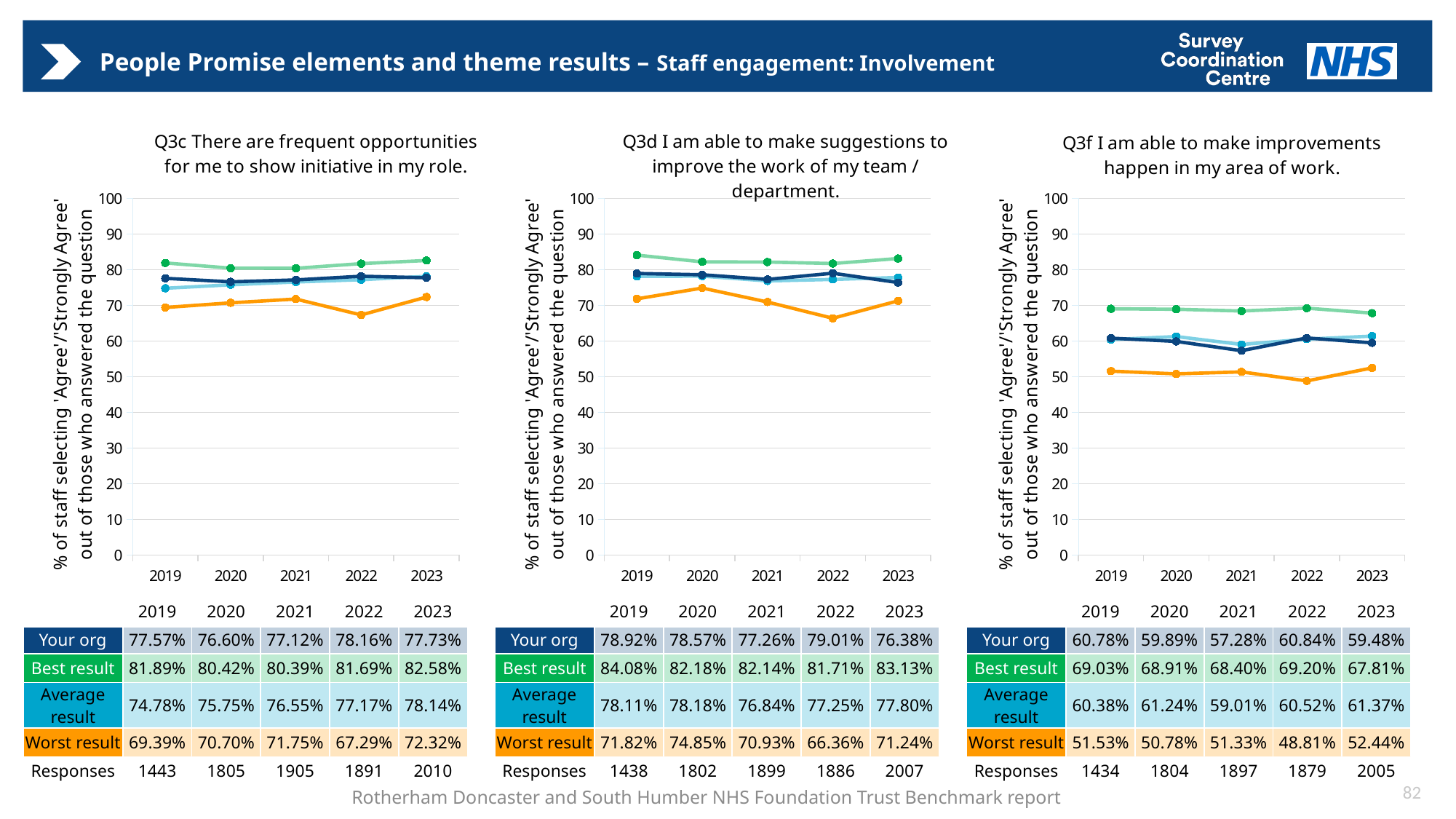
In the Q3f chart, in which year is the Worst result value lowest? 2022 In the Q3c chart, does the Average result line rise or fall from 2019 to 2023? rises In the Q3f chart, is the Worst result value for 2022 greater or less than 50? less In the Q3f chart, how many series (lines) are plotted? 4 In the Q3f chart, which is larger in 2021: the Your org value or the Average result value? Average result What kind of chart is the Q3d chart? line chart In the Q3d chart (I am able to make suggestions to improve the work of my team / department), what is the Worst result value for 2022? 66.36% In the Q3c chart, how many years are shown on the x axis? 5 In the Q3c chart, what is the difference between the Best result and Your org values in 2023? 4.85 percentage points In the Q3d chart, in which year is the Best result value highest? 2019 In the Q3c chart (There are frequent opportunities for me to show initiative in my role), what is the Your org value for 2022? 78.16% In the Q3f chart (I am able to make improvements happen in my area of work), what is the Best result value for 2023? 67.81%